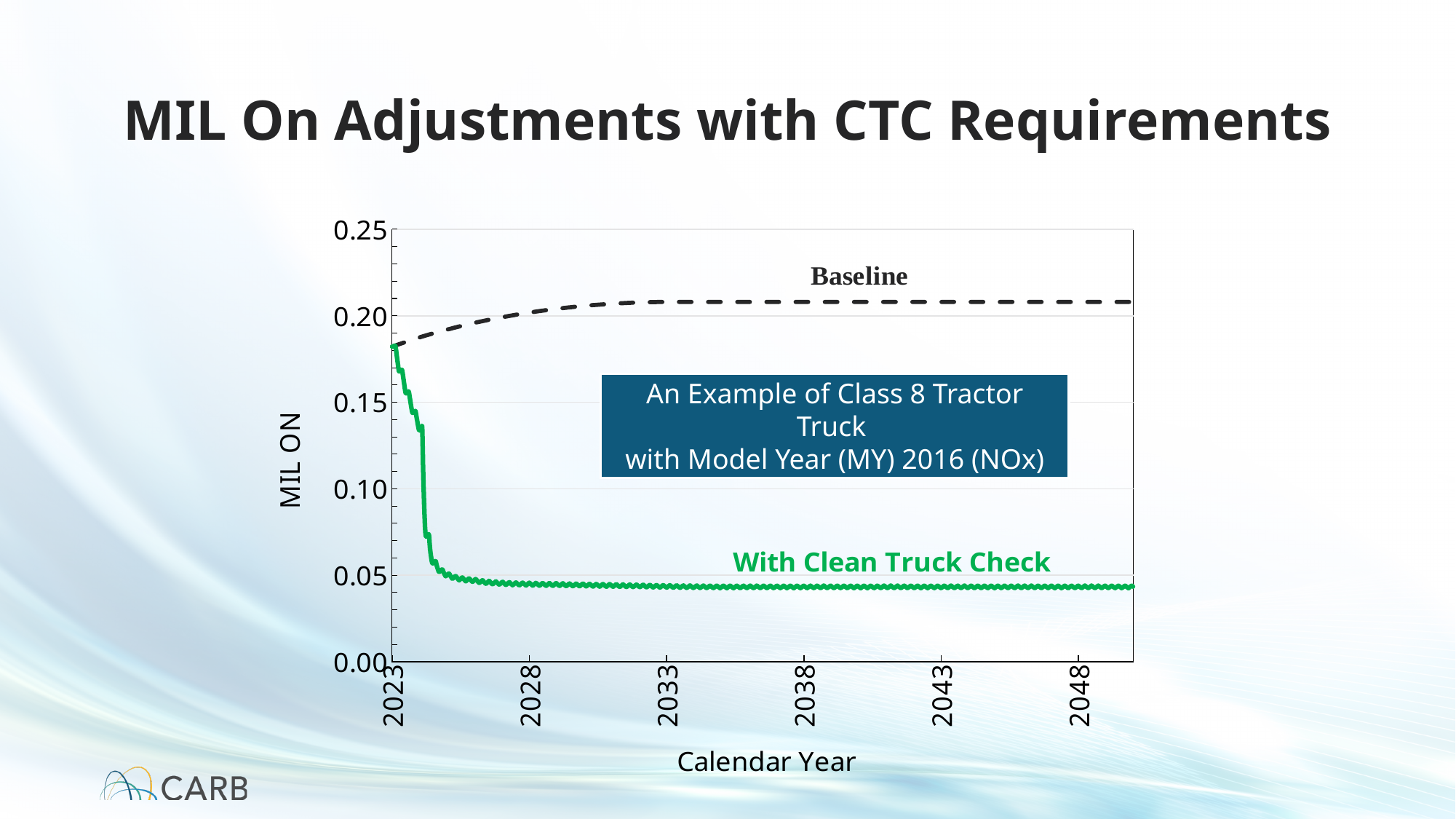
How many data series are plotted on the chart? 2 What kind of chart is shown on the slide? line chart Is the Baseline value in 2048 greater or less than 0.20? greater Does the Baseline series rise or fall between 2023 and 2033? rise What is the label of the y axis? MIL ON How many year labels are shown on the x axis? 6 Is the With Clean Truck Check value in 2023 greater or less than 0.15? greater Is the Baseline value in 2023 greater or less than 0.20? less What is the title of the slide's chart? MIL On Adjustments with CTC Requirements Does the With Clean Truck Check series rise or fall between 2023 and 2028? fall Which series is higher in calendar year 2040, Baseline or With Clean Truck Check? Baseline